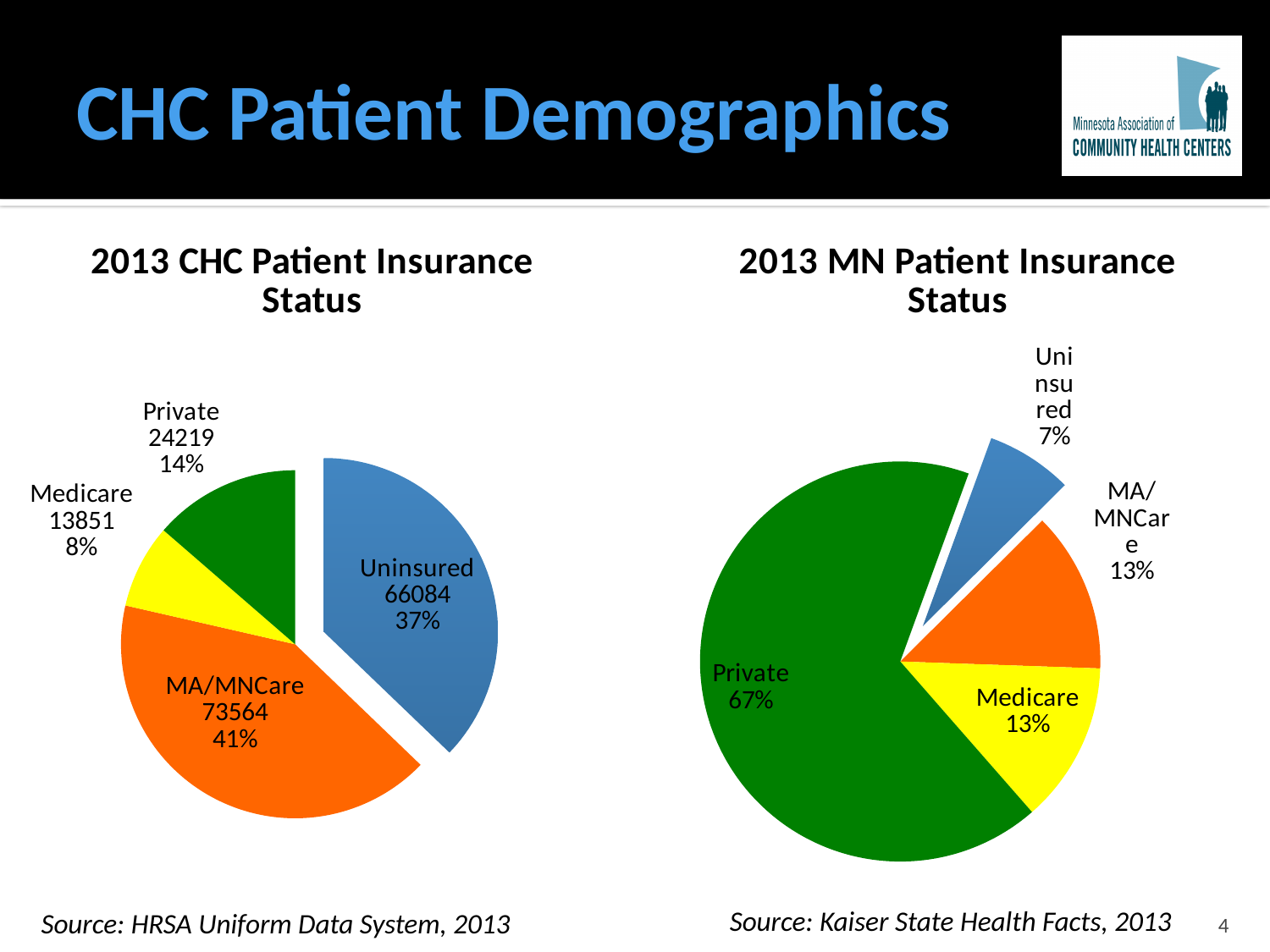
In the 2013 MN Patient Insurance Status chart, which category has the smallest share? Uninsured In the 2013 CHC Patient Insurance Status chart, how many patients have Private insurance? 24219 Which is larger: the Uninsured share in the 2013 CHC Patient Insurance Status chart or the Uninsured share in the 2013 MN Patient Insurance Status chart? 2013 CHC Patient Insurance Status How many categories does the 2013 MN Patient Insurance Status chart show? 4 In the 2013 CHC Patient Insurance Status chart, which insurance category has the largest number of patients? MA/MNCare In the 2013 CHC Patient Insurance Status chart, which insurance category has the fewest patients? Medicare In the 2013 CHC Patient Insurance Status chart, what is the difference between the number of MA/MNCare patients and Uninsured patients? 7480 In the 2013 MN Patient Insurance Status chart, what share of patients have Private insurance? 67% What type of chart is the 2013 CHC Patient Insurance Status chart? Pie chart In the 2013 CHC Patient Insurance Status chart, how many patients are Uninsured? 66084 In the 2013 CHC Patient Insurance Status chart, what share of patients are covered by MA/MNCare? 41% In the 2013 MN Patient Insurance Status chart, what share of patients are Uninsured? 7%